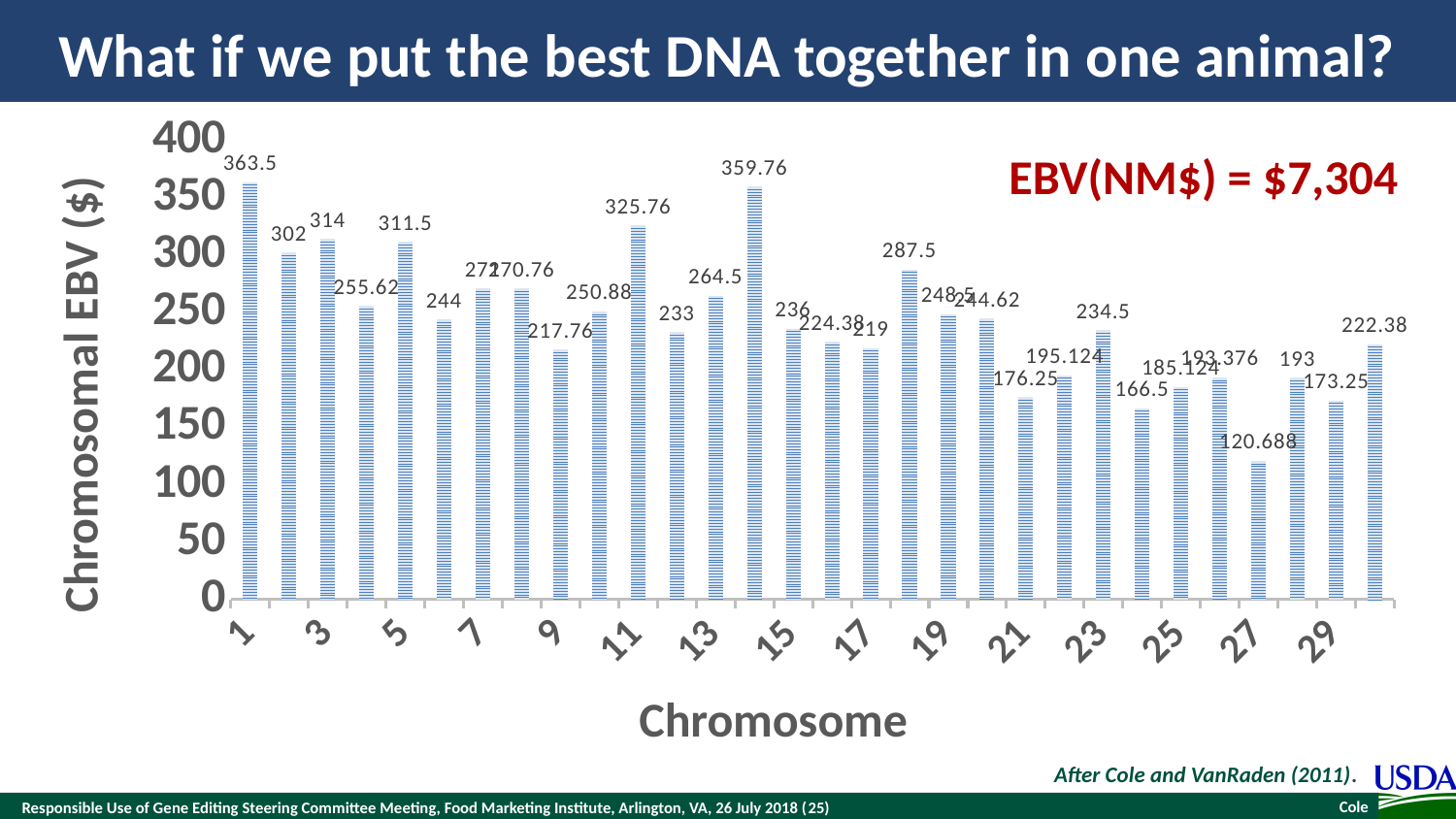
Which chromosome has the lowest chromosomal EBV? Chromosome 27 What is the chromosomal EBV value for chromosome 1? 363.5 What is the chromosomal EBV value for chromosome 30 (the last bar)? 222.38 What is the difference between the chromosomal EBV of chromosome 1 and chromosome 27? 242.812 What is the chromosomal EBV value for chromosome 27? 120.688 Which chromosome has the highest chromosomal EBV? Chromosome 1 How many chromosomes (bars) are plotted in the chart? 30 Which has a larger chromosomal EBV, chromosome 11 or chromosome 18? Chromosome 11 What is the title of the y-axis of the chart? Chromosomal EBV ($) What is the chromosomal EBV value for chromosome 14? 359.76 Is the chromosomal EBV for chromosome 27 greater or less than 150? less What kind of chart is shown on the slide? Bar chart